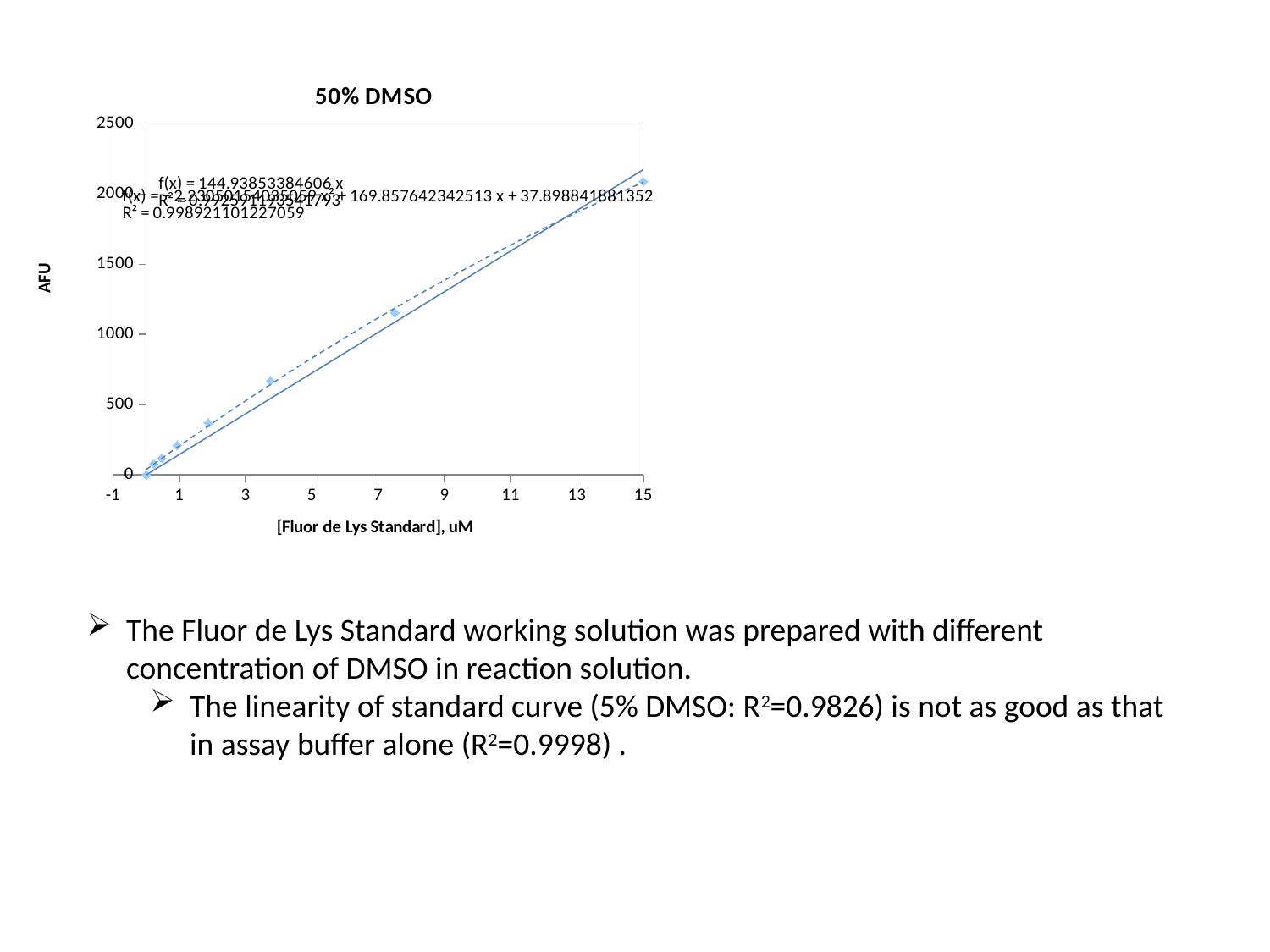
Is the AFU value at 15 uM greater or less than 2000? greater What is the title of the chart? 50% DMSO What is the slope of the linear trendline equation f(x) shown on the chart? 144.93853384606 What is the label of the x axis of the chart? [Fluor de Lys Standard], uM Which has the larger AFU value, the point at about 7.5 uM or the point at 15 uM? 15 uM Is the AFU value at about 3.75 uM greater or less than 500? greater What is the highest value shown on the y axis of the chart? 2500 Is the AFU value at about 7.5 uM greater or less than 1000? greater What kind of chart is shown on the slide? scatter chart Do the AFU values rise or fall as the Fluor de Lys Standard concentration increases? rise At which concentration on the x axis is the AFU value highest? 15